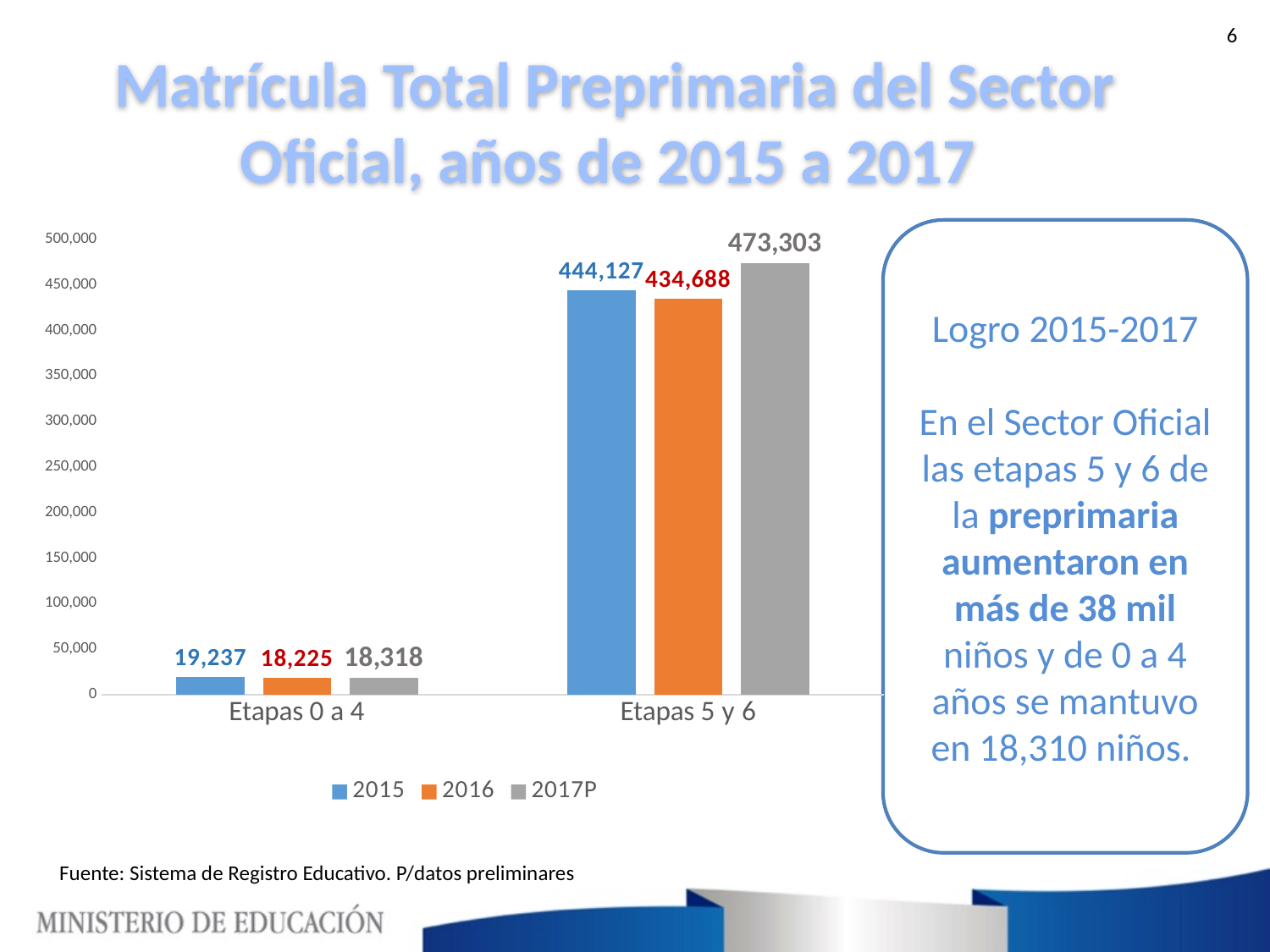
What is the value for 2016 in the Etapas 0 a 4 category? 18,225 How many categories are shown on the x axis? 2 Which is larger in the Etapas 0 a 4 category: the 2016 value or the 2017P value? 2017P What is the value for 2015 in the Etapas 0 a 4 category? 19,237 Which series has the highest value in the Etapas 5 y 6 category? 2017P What is the difference between the 2017P and 2015 values in the Etapas 5 y 6 category? 29,176 What is the value for 2015 in the Etapas 5 y 6 category? 444,127 What is the difference between the 2015 and 2016 values in the Etapas 0 a 4 category? 1,012 What is the value for 2017P in the Etapas 5 y 6 category? 473,303 How many series does the legend list? 3 Which series has the lowest value in the Etapas 5 y 6 category? 2016 What type of chart is shown on the slide? bar chart